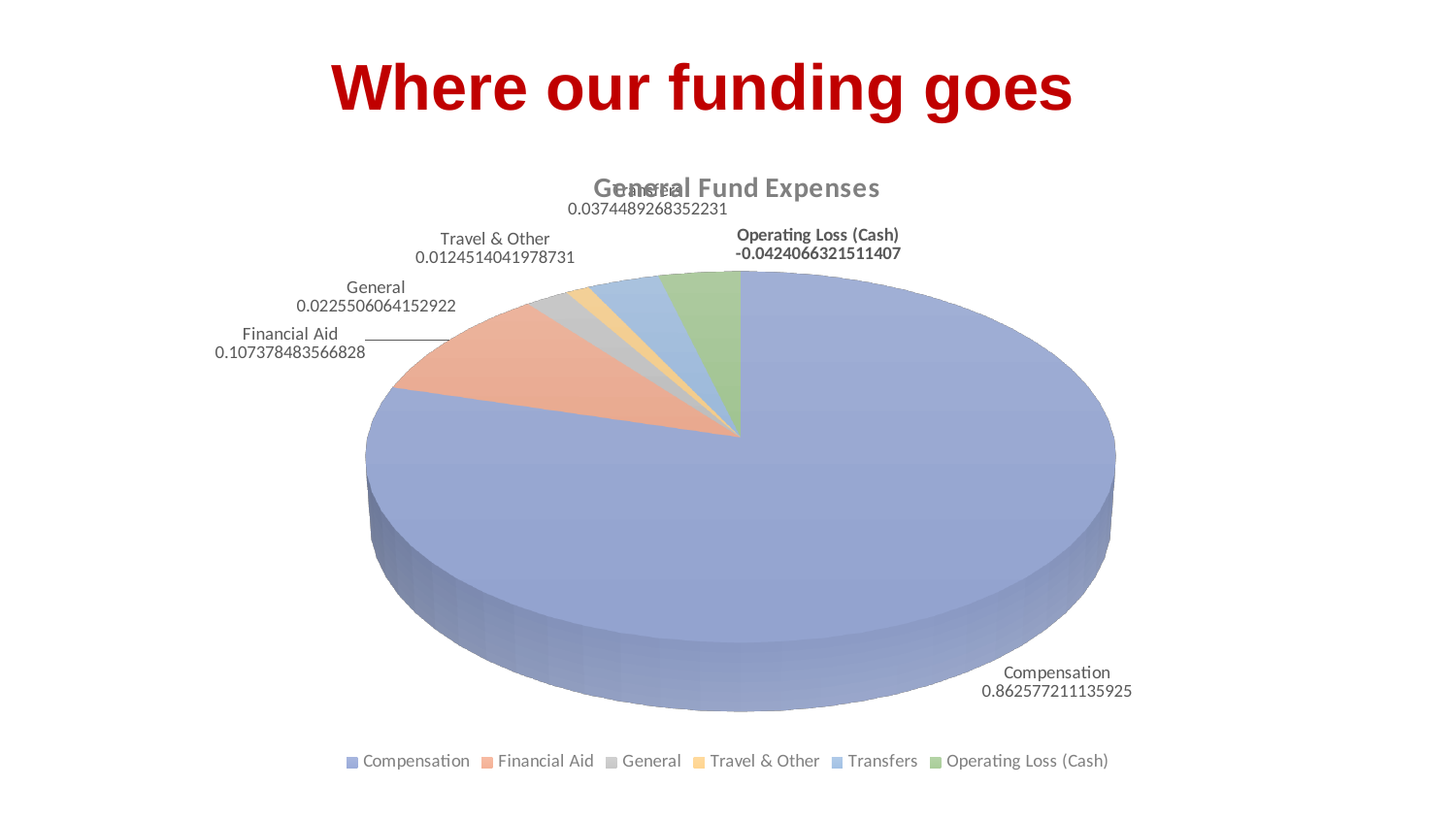
What is the value shown for General? 0.0225506064152922 What is the value shown for Travel & Other? 0.0124514041978731 What colour is the Compensation slice? Blue Which category has the largest slice of the pie? Compensation Which is larger, Travel & Other or Transfers? Transfers What is the value shown for Compensation? 0.862577211135925 What is the value shown for Financial Aid? 0.107378483566828 How many categories does the legend list? 6 What is the value shown for Operating Loss (Cash)? -0.0424066321511407 Which is larger, Financial Aid or General? Financial Aid What is the title of the chart? General Fund Expenses What type of chart is shown on the slide? Pie chart